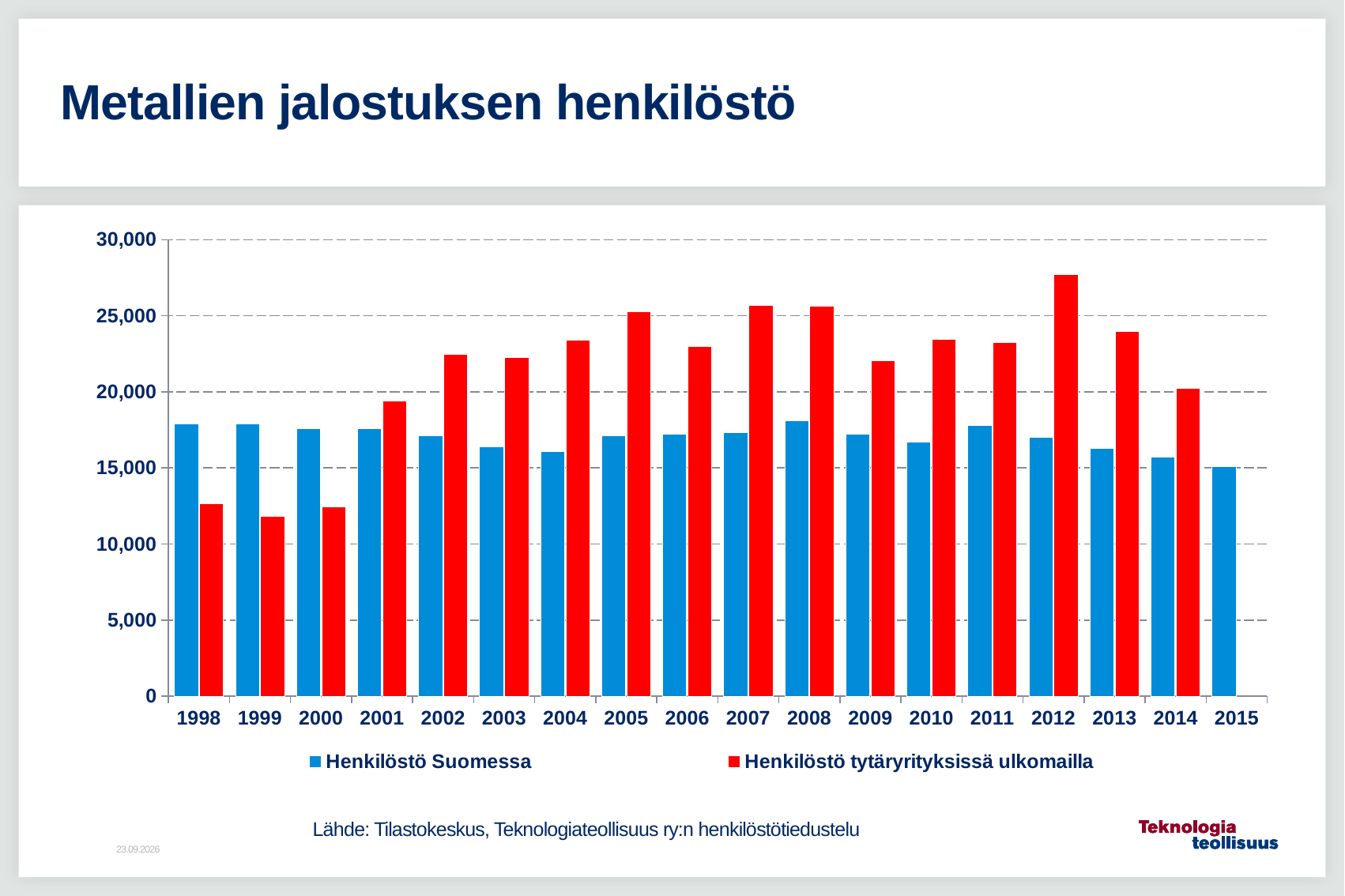
In which year is the value for Henkilöstö tytäryrityksissä ulkomailla highest? 2012 Is the value for Henkilöstö tytäryrityksissä ulkomailla in 2012 greater or less than 25,000? greater In 2007, which series has the larger value, Henkilöstö Suomessa or Henkilöstö tytäryrityksissä ulkomailla? Henkilöstö tytäryrityksissä ulkomailla Is the value for Henkilöstö tytäryrityksissä ulkomailla in 2009 greater or less than 20,000? greater How many series does the legend list? 2 What kind of chart is shown on the slide? bar chart Does the value for Henkilöstö Suomessa rise or fall from 2011 to 2015? fall In 1998, which series has the larger value, Henkilöstö Suomessa or Henkilöstö tytäryrityksissä ulkomailla? Henkilöstö Suomessa In which year is the value for Henkilöstö tytäryrityksissä ulkomailla lowest? 1999 Is the value for Henkilöstö tytäryrityksissä ulkomailla in 1999 greater or less than 15,000? less In which year is the value for Henkilöstö Suomessa lowest? 2015 How many years are shown on the x axis? 18